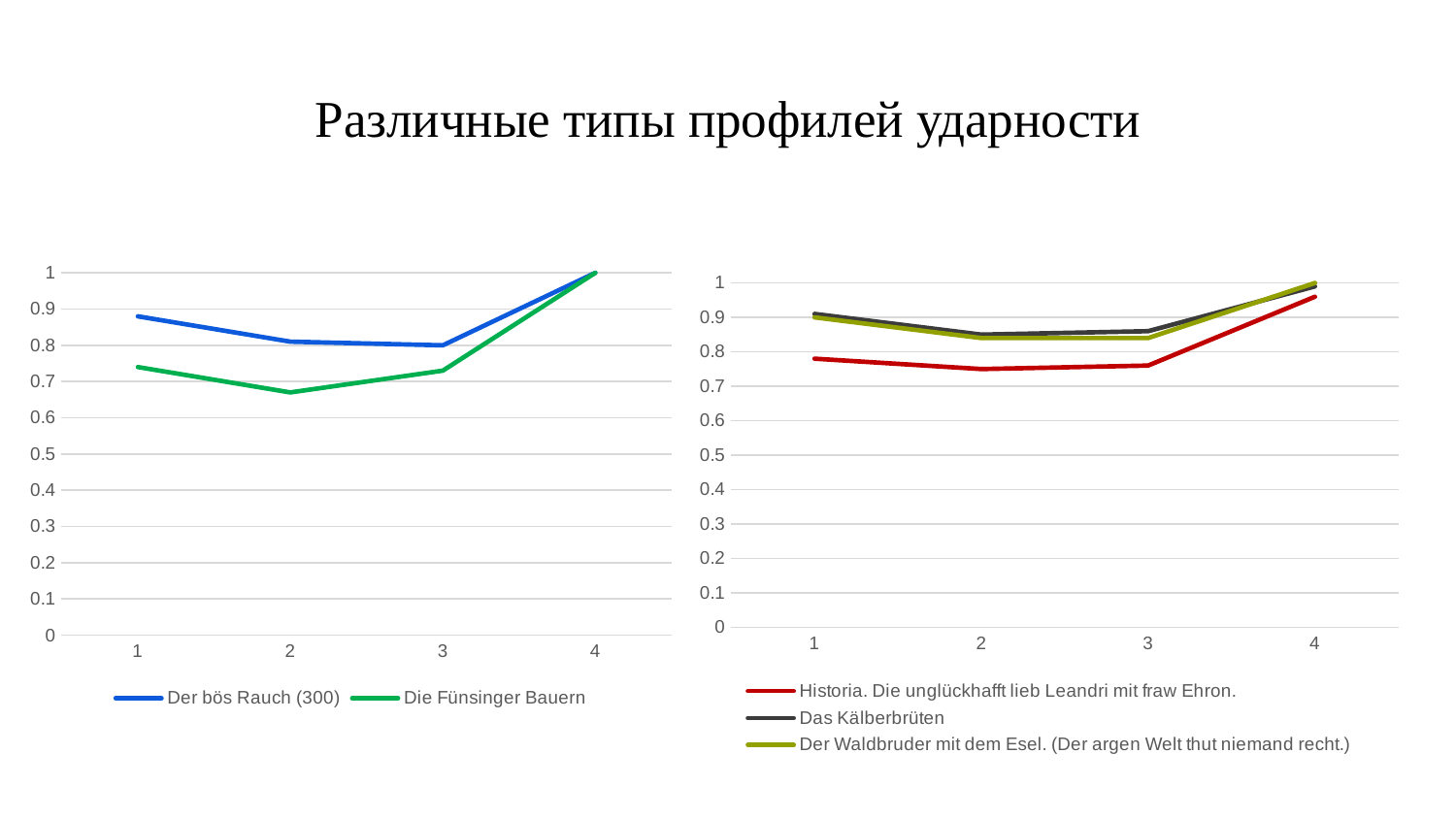
In the right-hand chart, which series has the lowest value at point 1? Historia. Die unglückhafft lieb Leandri mit fraw Ehron. In the left-hand chart, what is the value of Der bös Rauch (300) at point 4? 1 In the left-hand chart, what is the value of Die Fünsinger Bauern at point 4? 1 In the left-hand chart, is the value for Die Fünsinger Bauern at point 2 greater or less than 0.7? less What kind of chart is the chart on the left of the slide? line chart In the right-hand chart, do the values of Das Kälberbrüten rise or fall from point 3 to point 4? rise In the left-hand chart, is the value for Der bös Rauch (300) at point 1 greater or less than 0.8? greater How many series does the legend of the left-hand chart list? 2 In the right-hand chart, is the value for Historia. Die unglückhafft lieb Leandri mit fraw Ehron. at point 2 greater or less than 0.8? less In the left-hand chart, which series is higher at point 1, Der bös Rauch (300) or Die Fünsinger Bauern? Der bös Rauch (300) How many points are plotted along the x axis of the left-hand chart for each series? 4 How many series does the legend of the right-hand chart list? 3